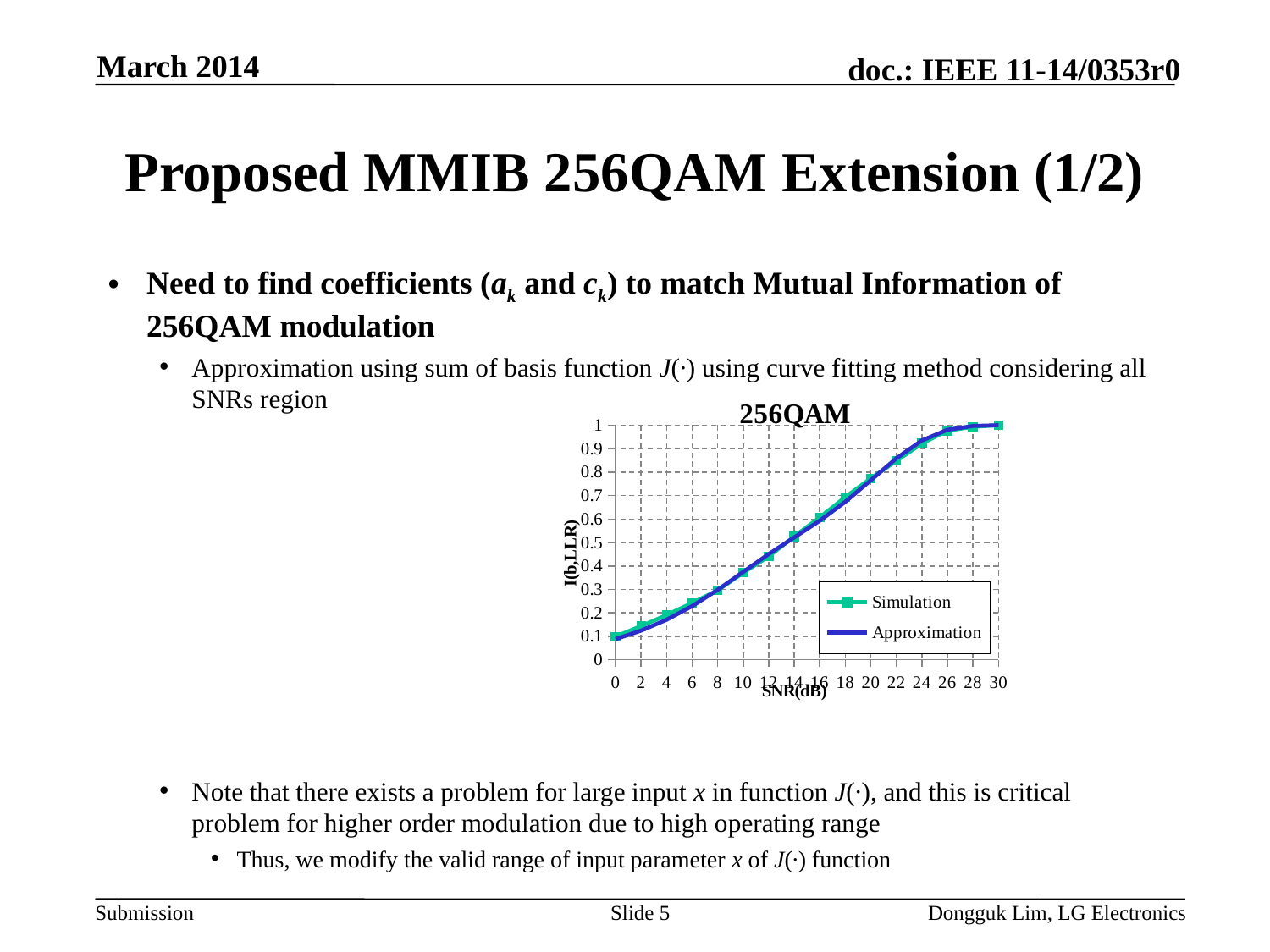
What is the title of the chart? 256QAM Which series in the chart is drawn in green with square markers? Simulation Do the plotted values rise or fall as SNR(dB) increases from 0 to 30? rise What kind of chart is shown on the slide? line chart Which is larger for the Simulation series: the value at SNR 30 dB or the value at SNR 0 dB? SNR 30 dB Is the Approximation value at SNR 4 dB greater or less than 0.3? less How many SNR(dB) tick values are shown along the x axis? 16 Is the Simulation value at SNR 20 dB greater or less than 0.7? greater How many series does the chart legend list? 2 Is the Simulation value at SNR 0 dB greater or less than 0.2? less